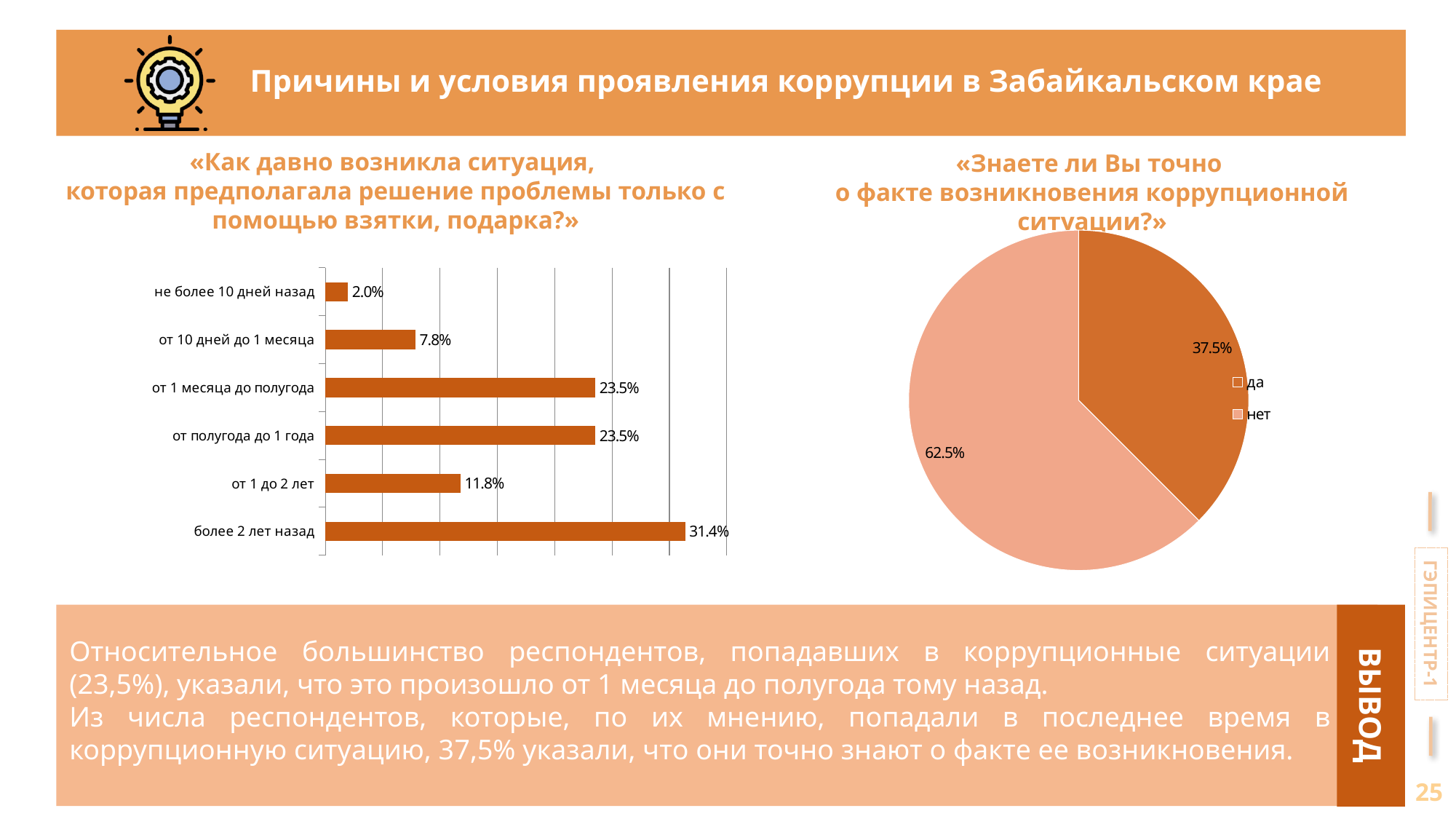
In the right pie chart, what share of respondents answered «да»? 37.5% How many categories are shown in the left bar chart? 6 In the left bar chart, what is the value for «от 10 дней до 1 месяца»? 7.8% In the left bar chart, which is larger: «от 1 до 2 лет» or «от 10 дней до 1 месяца»? от 1 до 2 лет In the right pie chart, what is the value for «нет»? 62.5% How many entries does the legend of the right pie chart list? 2 In the right pie chart, which slice is larger: «да» or «нет»? нет In the left bar chart, which category has the highest value? более 2 лет назад In the left bar chart, what is the value for «более 2 лет назад»? 31.4% What type of chart is the left chart? bar chart In the left bar chart, what is the difference between «более 2 лет назад» and «от 1 до 2 лет»? 19.6% In the left bar chart, which category has the lowest value? не более 10 дней назад